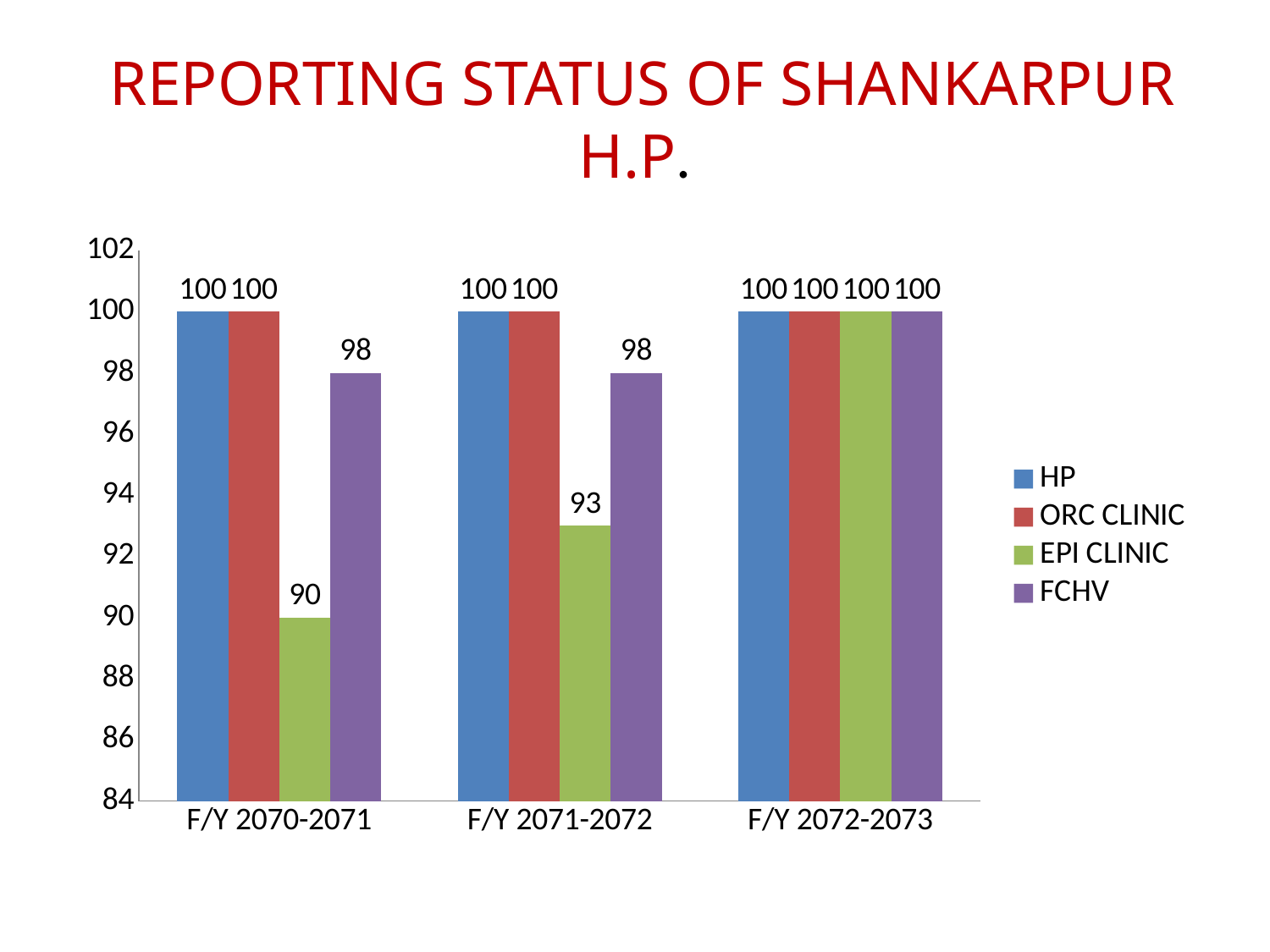
Which series has the lowest value in F/Y 2070-2071? EPI CLINIC What is the difference between the FCHV value and the EPI CLINIC value in F/Y 2070-2071? 8 What is the value for HP in F/Y 2072-2073? 100 What is the value for FCHV in F/Y 2071-2072? 98 How many fiscal year categories are shown on the x axis? 3 What kind of chart is shown on the slide? Bar chart What is the value for EPI CLINIC in F/Y 2070-2071? 90 How many series does the legend list? 4 Which is larger in F/Y 2071-2072, the ORC CLINIC value or the FCHV value? ORC CLINIC What is the value for EPI CLINIC in F/Y 2071-2072? 93 Do the EPI CLINIC values rise or fall across the fiscal years from F/Y 2070-2071 to F/Y 2072-2073? Rise What is the difference between the EPI CLINIC values in F/Y 2071-2072 and F/Y 2070-2071? 3